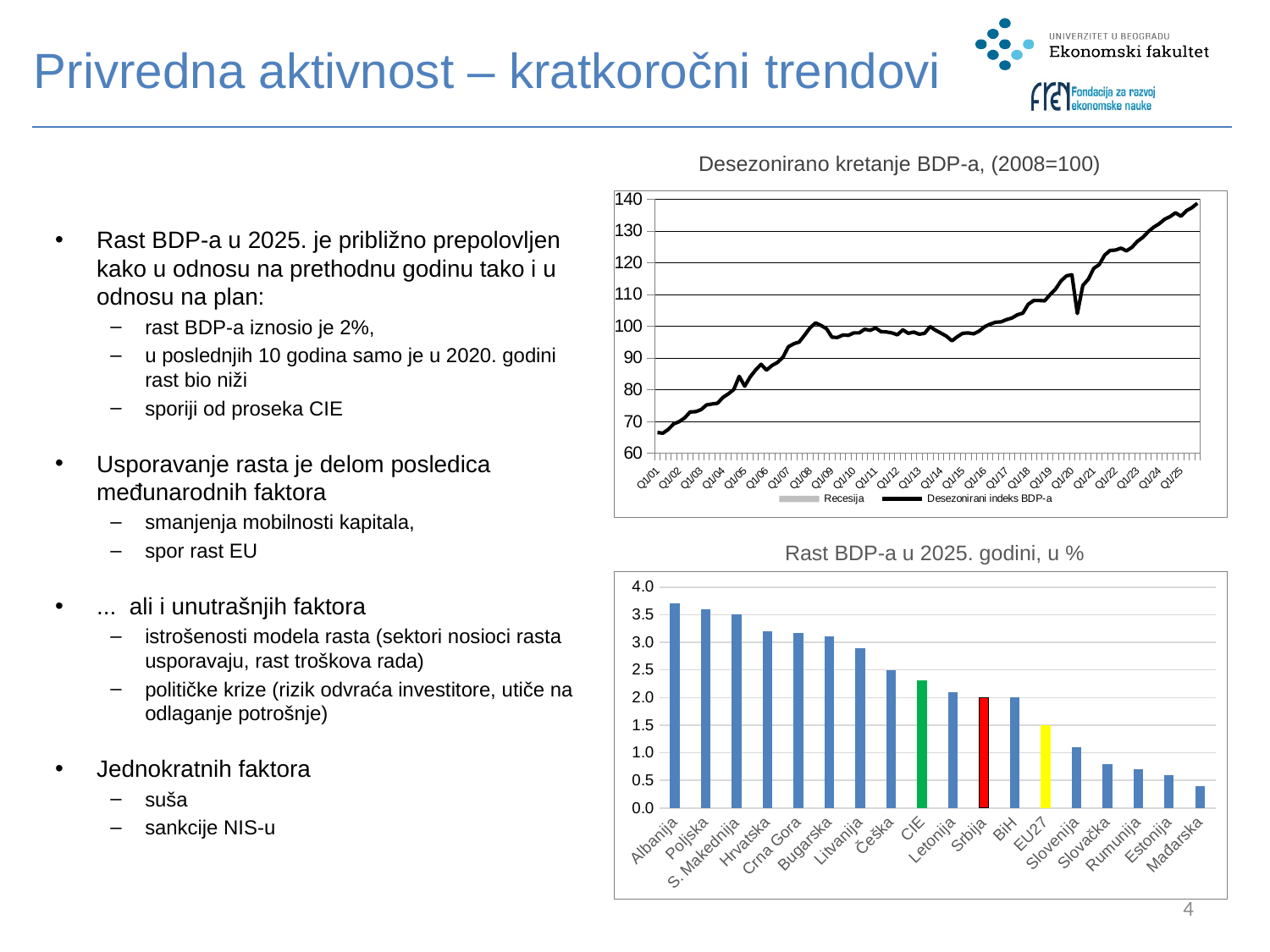
On the chart titled 'Rast BDP-a u 2025. godini, u %', what is the value for EU27? 1.5 On the chart titled 'Rast BDP-a u 2025. godini, u %', is the value for Mađarska greater or less than 0.5? less On the chart titled 'Rast BDP-a u 2025. godini, u %', which country has the highest GDP growth? Albanija What kind of chart is 'Desezonirano kretanje BDP-a, (2008=100)'? Line chart On the chart titled 'Rast BDP-a u 2025. godini, u %', how many countries/regions are shown on the x axis? 18 How many series does the legend of the chart 'Desezonirano kretanje BDP-a, (2008=100)' list? 2 On the chart titled 'Rast BDP-a u 2025. godini, u %', what colour is the bar for Srbija? Red On the chart titled 'Rast BDP-a u 2025. godini, u %', which has the larger value, Hrvatska or Slovenija? Hrvatska On the chart titled 'Rast BDP-a u 2025. godini, u %', is the value for Albanija greater or less than 3.5? greater On the chart titled 'Desezonirano kretanje BDP-a, (2008=100)', does the index generally rise or fall from Q1/01 to Q1/25? Rise On the chart titled 'Rast BDP-a u 2025. godini, u %', is the value for Češka greater or less than 2.0? greater On the chart titled 'Rast BDP-a u 2025. godini, u %', which country has the lowest GDP growth? Mađarska